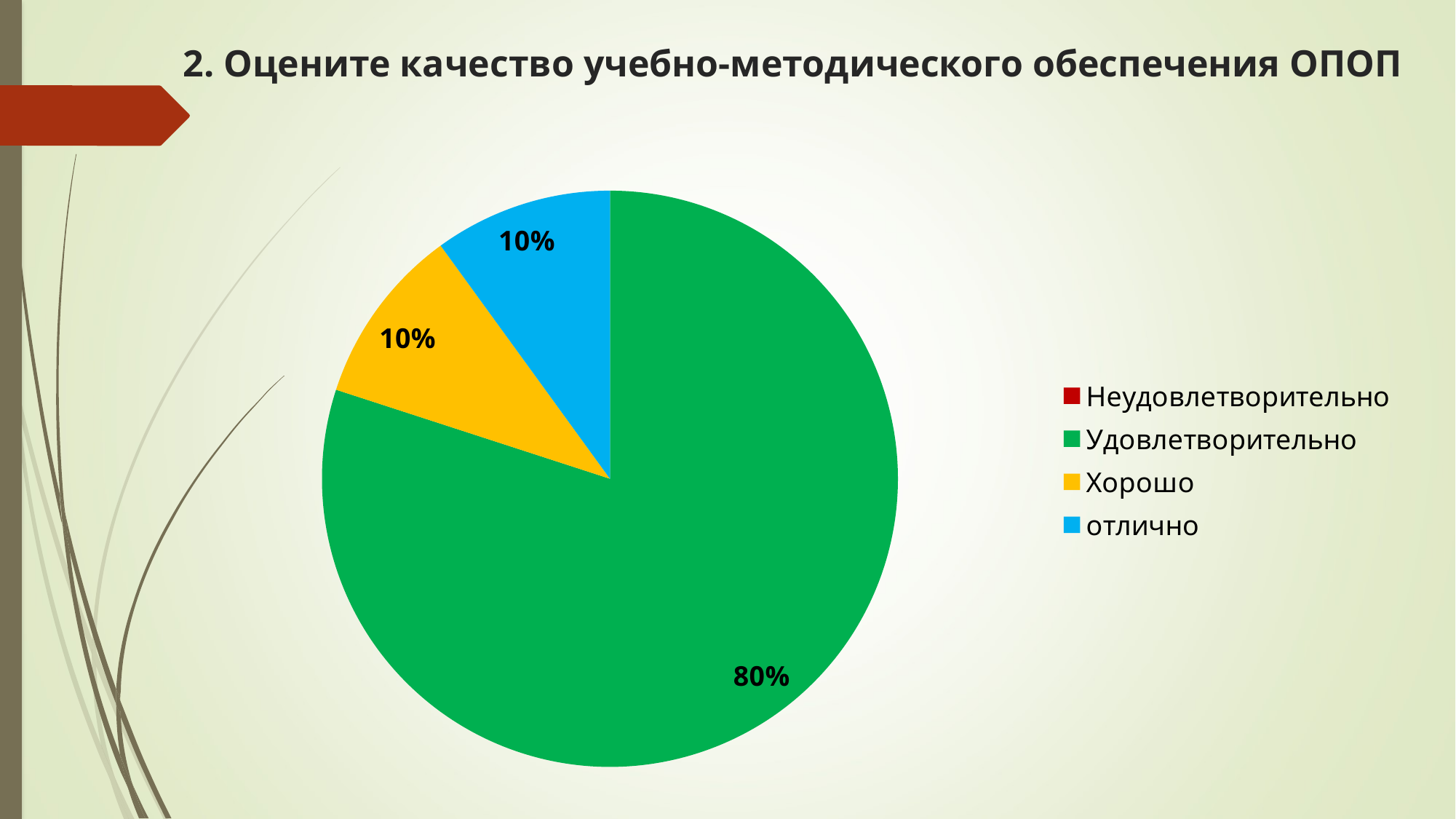
What is the value shown for Хорошо? 10% Which is larger, the slice for Удовлетворительно or the slice for отлично? Удовлетворительно How many entries does the legend list? 4 Which category has the largest slice of the pie? Удовлетворительно What share of the pie does Удовлетворительно take? 80% How many slices are visible in the pie? 3 What kind of chart is shown on the slide? pie chart What colour is the slice for Хорошо? yellow What is the difference between the values for Удовлетворительно and Хорошо? 70% What is the title of the chart? 2. Оцените качество учебно-методического обеспечения ОПОП What is the value shown for отлично? 10% Is the value for Удовлетворительно greater or less than 50%? greater